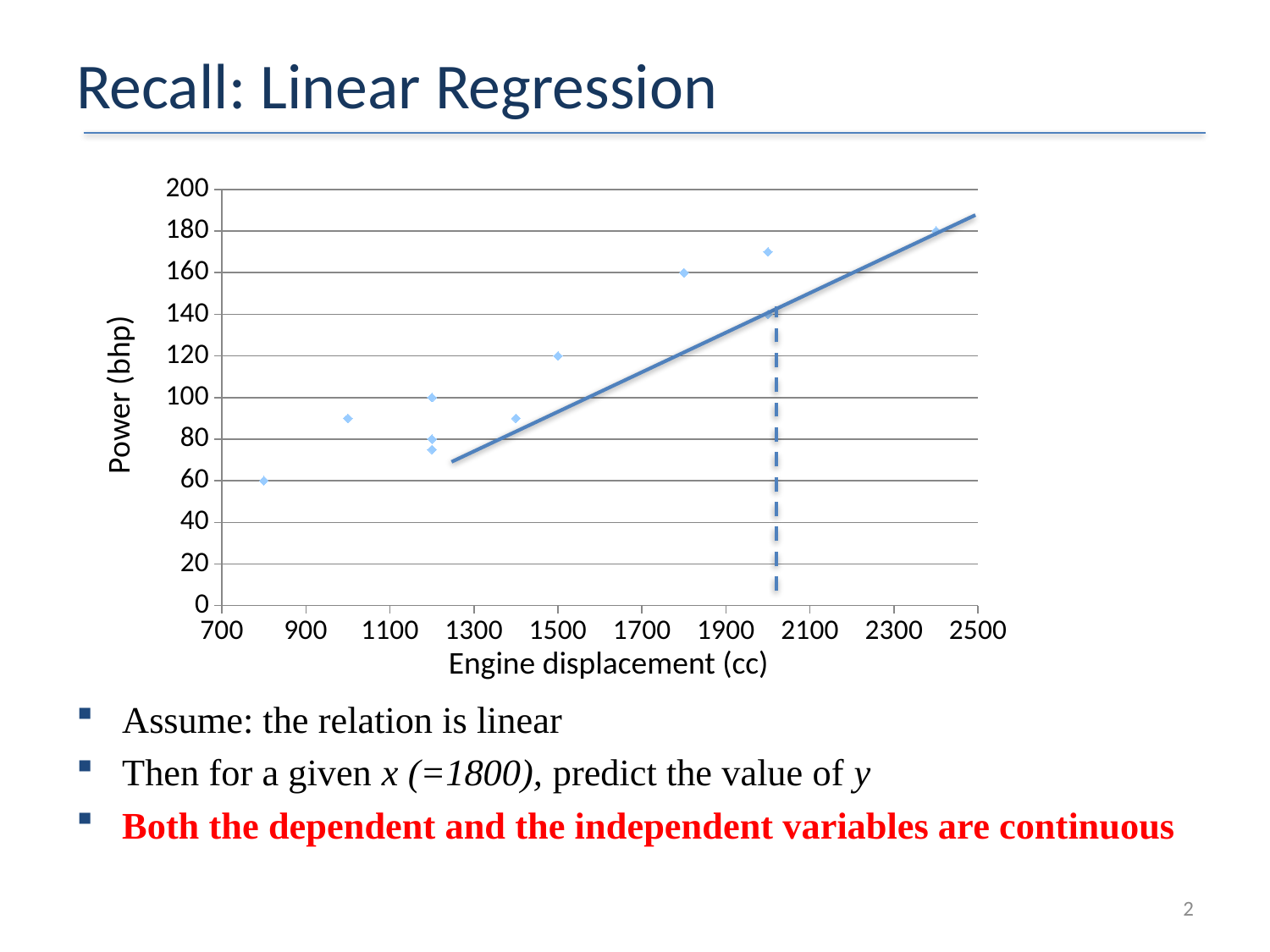
What is the title of the x axis of the chart? Engine displacement (cc) What is the power (bhp) of the data point at 1500 cc engine displacement? 120 Do the plotted power values generally rise or fall as engine displacement increases? rise What is the title of the y axis of the chart? Power (bhp) Is the power of the lowest data point greater or less than 80 bhp? less What is the highest value shown on the y axis of the chart? 200 What is the power (bhp) of the leftmost data point on the chart? 60 What kind of chart is shown on the slide? scatter chart Which has the higher power: the data point at 1500 cc or the data point near 1000 cc? the point at 1500 cc What is the power (bhp) of the highest data point on the chart? 180